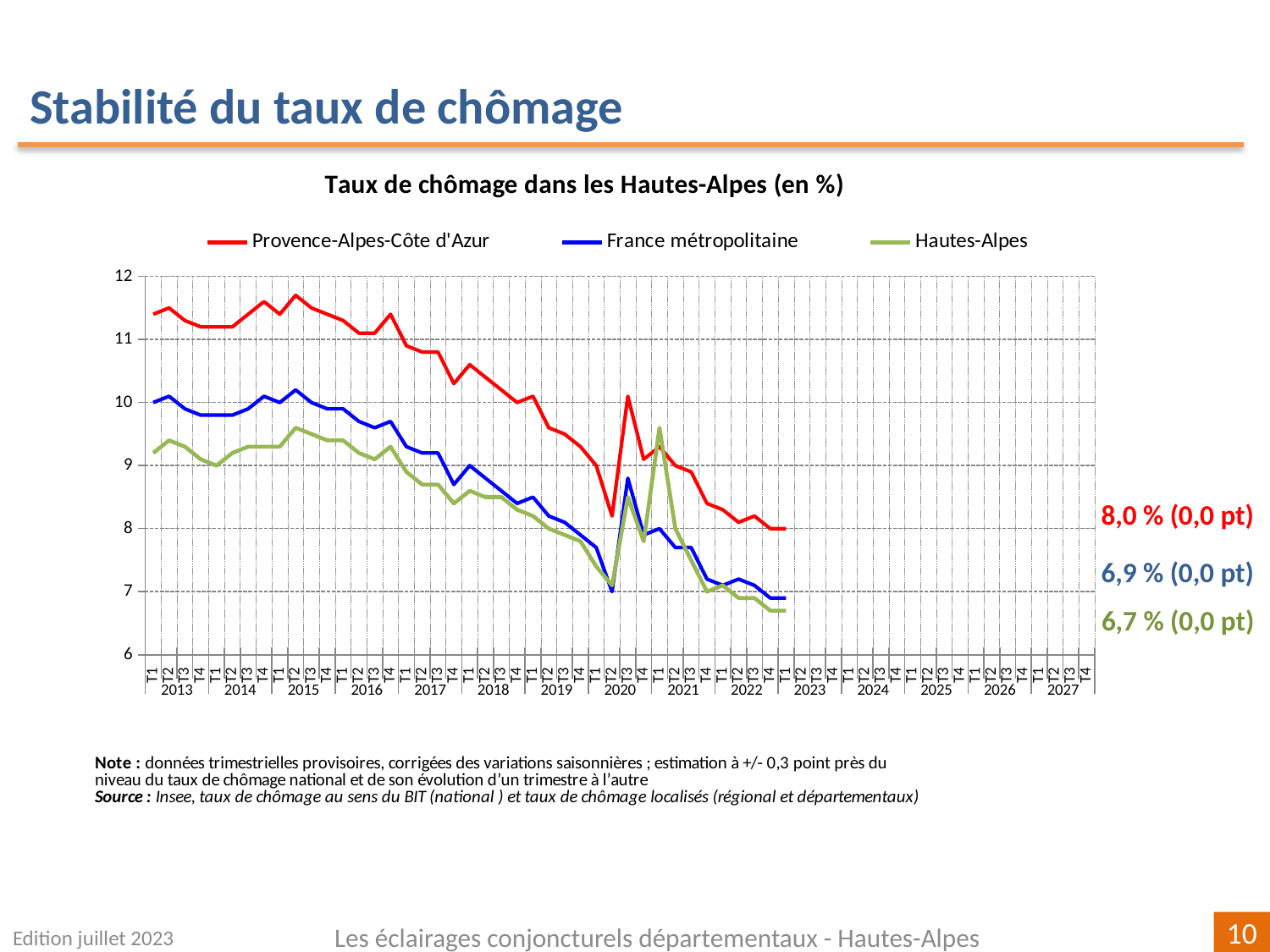
What kind of chart is shown on the slide? line chart What is the title of the chart? Taux de chômage dans les Hautes-Alpes (en %) Is the value for Provence-Alpes-Côte d'Azur in T2 2015 greater or less than 11? greater What is the latest value shown for France métropolitaine? 6,9 % Which series has the highest latest value? Provence-Alpes-Côte d'Azur What is the latest value shown for Provence-Alpes-Côte d'Azur? 8,0 % Is the latest value for France métropolitaine larger or smaller than the latest value for Hautes-Alpes? larger Which series has the lowest latest value? Hautes-Alpes Over the period from 2013 to 2023, does the Hautes-Alpes series generally rise or fall? fall How many series does the legend list? 3 What is the difference in points between the latest values for Provence-Alpes-Côte d'Azur and Hautes-Alpes? 1,3 What is the latest value shown for Hautes-Alpes? 6,7 %